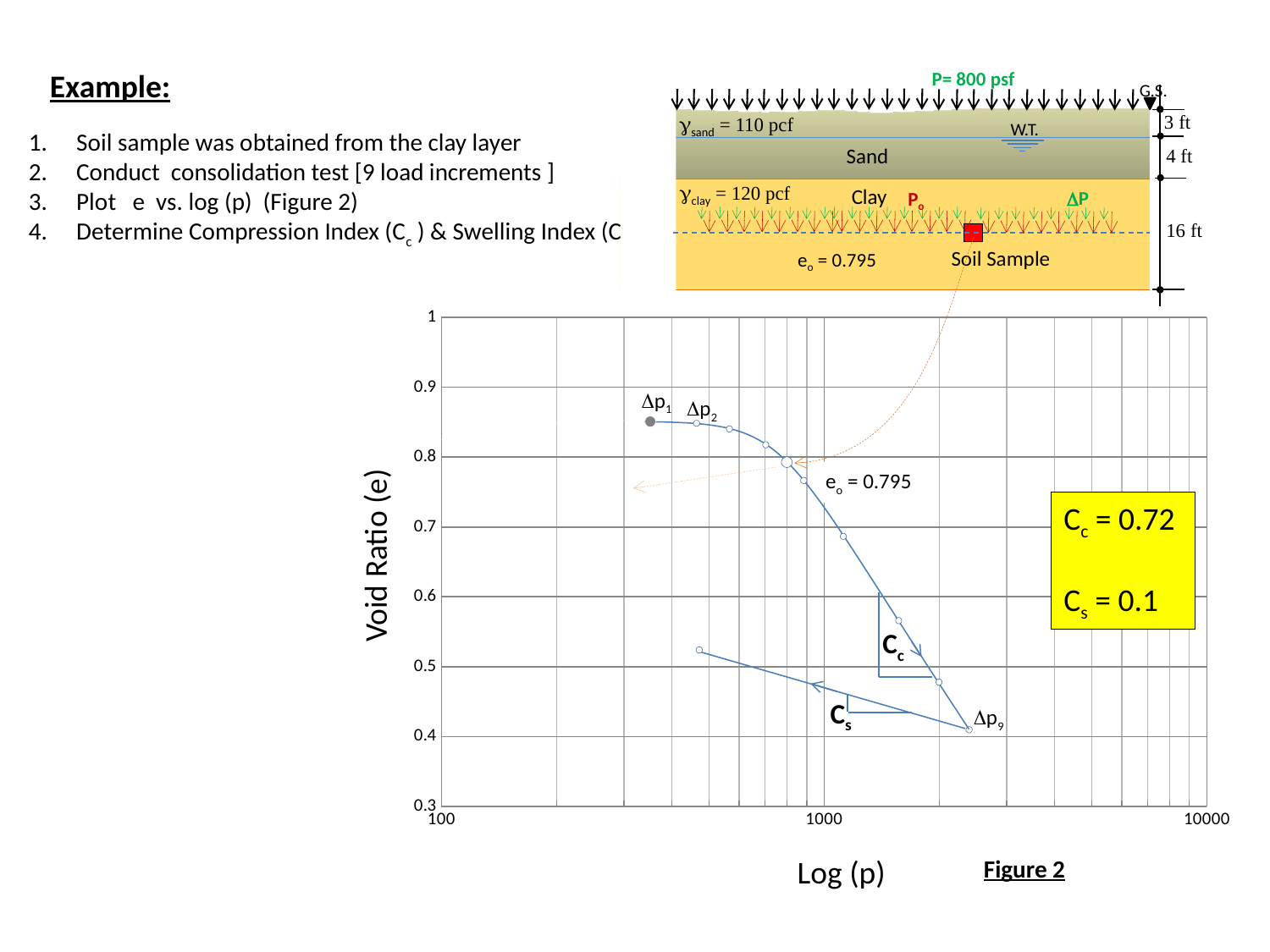
Is the void ratio at the point labelled Δp1 greater or less than 0.9? less Which of the labelled points has the lowest void ratio on the chart? Δp9 Which point has a higher void ratio, Δp1 or Δp9? Δp1 What value of the Swelling Index C_s is given on the slide? 0.1 What value of the Compression Index C_c is given on the slide? 0.72 Is the void ratio at the point labelled Δp9 greater or less than 0.5? less What is the label of the vertical axis of the chart? Void Ratio (e) Is the void ratio at the point labelled Δp1 greater or less than 0.8? greater What value of the initial void ratio e_o is marked on the chart? 0.795 What is the label of the horizontal axis of the chart? Log (p) What type of chart is shown in Figure 2? line chart Along the loading curve, does the void ratio rise or fall as the pressure p increases? fall